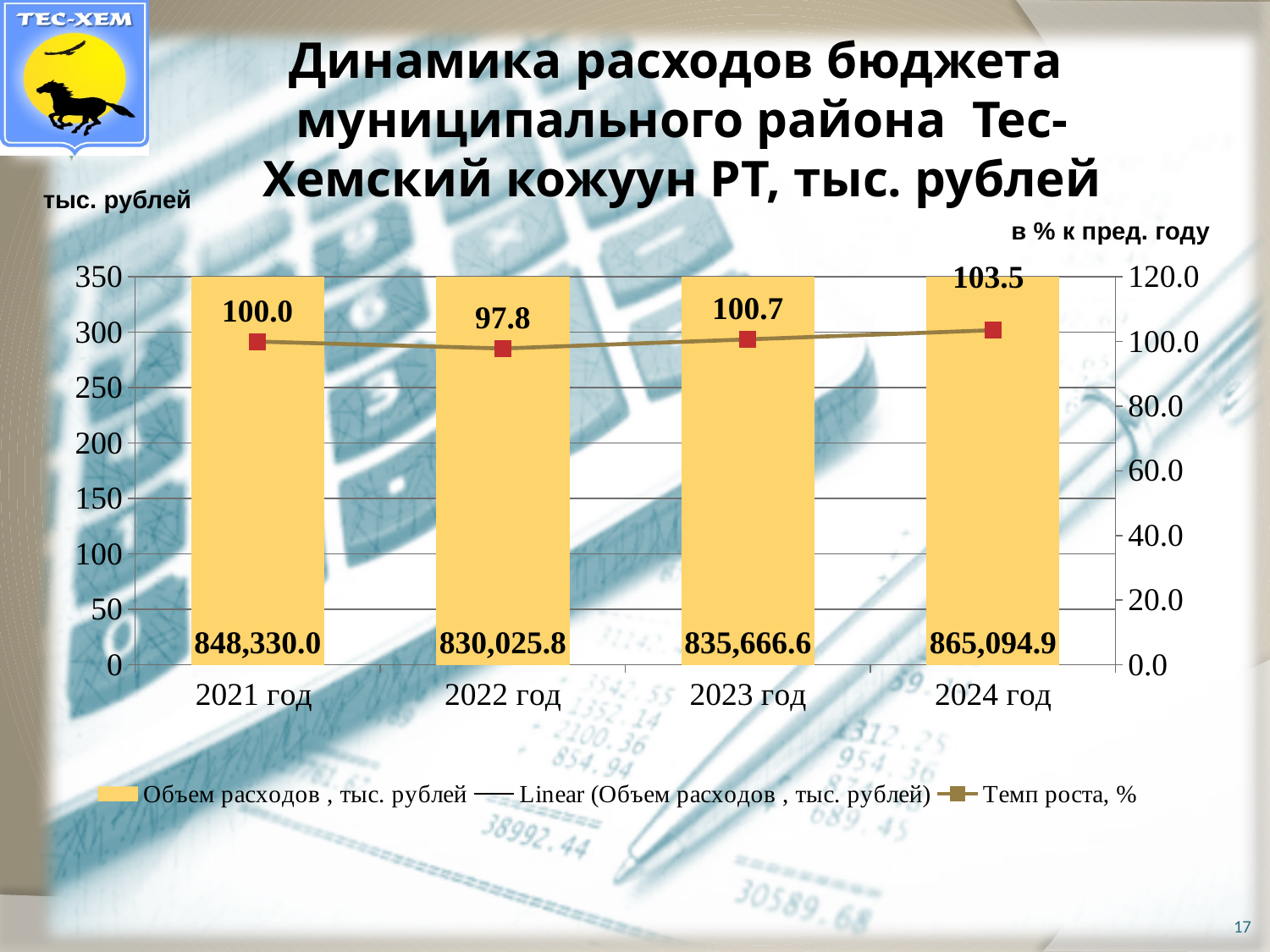
What is the Темп роста, % value for 2024 год? 103.5 Which is larger, the Объем расходов value for 2022 год or for 2023 год? 2023 год Which year has the lowest Темп роста, % value? 2022 год How many years are shown on the x axis? 4 What is the difference between the Объем расходов values for 2024 год and 2023 год? 29,428.3 What is the label of the right-hand axis? в % к пред. году How many entries does the legend list? 3 What is the value of Объем расходов for 2024 год? 865,094.9 Which year has the highest Объем расходов value? 2024 год What kind of chart is used for the Объем расходов series? bar chart What is the Темп роста, % value for 2022 год? 97.8 What is the value of Объем расходов for 2021 год? 848,330.0